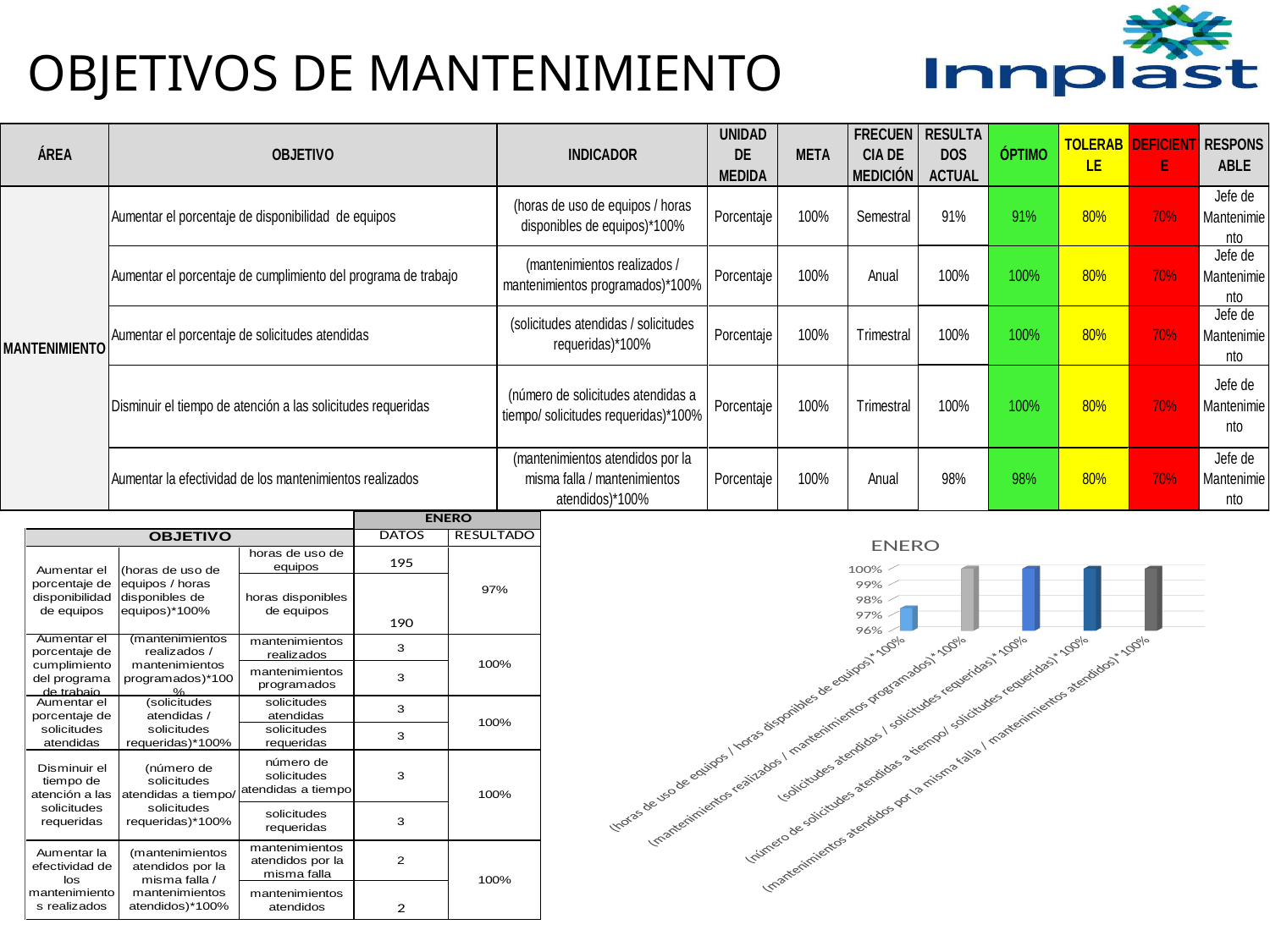
In the ENERO chart, which category has the lowest bar? (horas de uso de equipos / horas disponibles de equipos)*100% In the ENERO chart, is the value for (horas de uso de equipos / horas disponibles de equipos)*100% greater or less than 99%? less In the ENERO chart, is the value for (solicitudes atendidas / solicitudes requeridas)*100% greater or less than 97%? greater What type of chart is shown on the slide? bar chart In the ENERO chart, which is larger: the bar for (horas de uso de equipos / horas disponibles de equipos)*100% or the bar for (mantenimientos realizados / mantenimientos programados)*100%? (mantenimientos realizados / mantenimientos programados)*100% In the ENERO chart, which is larger: the bar for (número de solicitudes atendidas a tiempo/ solicitudes requeridas)*100% or the bar for (horas de uso de equipos / horas disponibles de equipos)*100%? (número de solicitudes atendidas a tiempo/ solicitudes requeridas)*100% In the ENERO chart, is the value for (mantenimientos realizados / mantenimientos programados)*100% greater or less than 98%? greater What is the title of the chart on the slide? ENERO How many bars are plotted in the ENERO chart? 5 What is the lowest value shown on the vertical axis of the ENERO chart? 96%